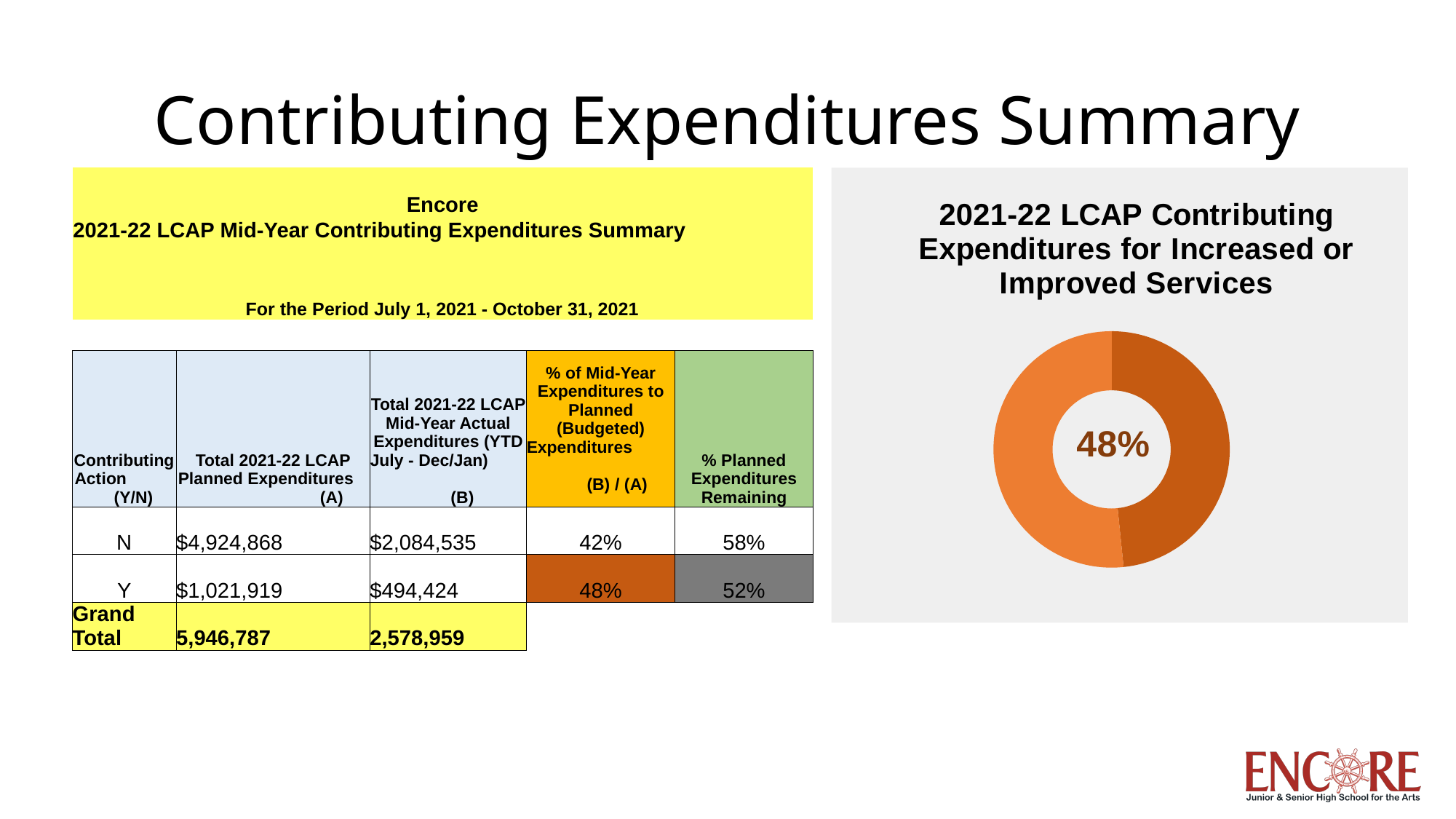
What percentage is printed in the centre of the doughnut chart? 48% What is the title of the doughnut chart? 2021-22 LCAP Contributing Expenditures for Increased or Improved Services What kind of chart is shown on the right side of the slide? doughnut chart Is the percentage shown in the centre of the doughnut chart greater or less than 50%? less How many slices does the doughnut chart have? 2 Does the doughnut chart display a legend? No